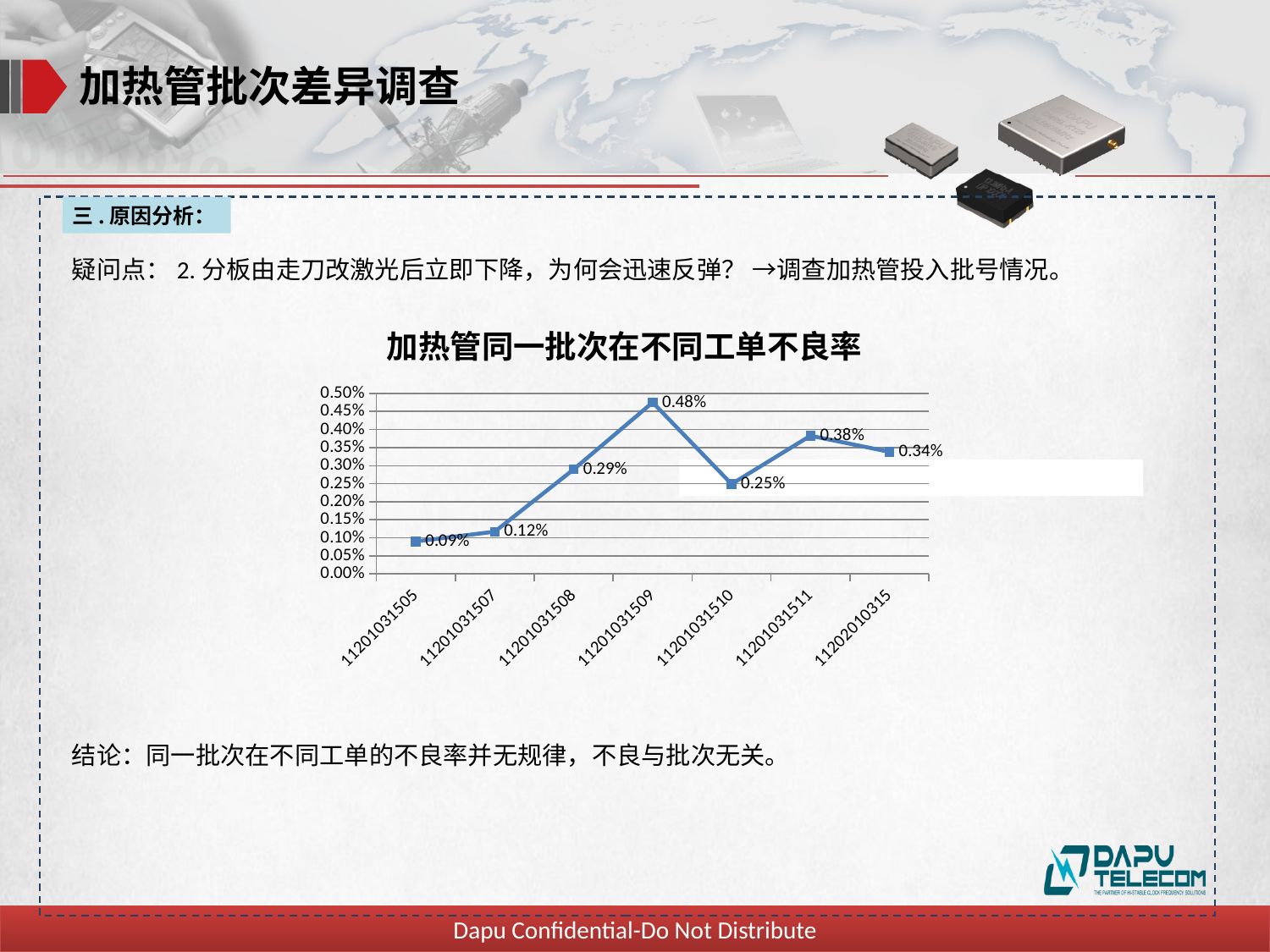
Does the defect rate rise or fall from work order 11201031505 to work order 11201031509? rise What is the defect rate for work order 11201031505? 0.09% What is the difference between the defect rates of work orders 11201031509 and 11201031510? 0.23% Which work order has the highest defect rate? 11201031509 How many work orders (data points) are plotted on the chart? 7 What is the defect rate for work order 11201031509? 0.48% What type of chart is shown on the slide? line chart Which work order has the lowest defect rate? 11201031505 Which has a higher defect rate, work order 11201031511 or work order 11201031508? 11201031511 What is the title of the chart? 加热管同一批次在不同工单不良率 What is the defect rate for work order 11202010315? 0.34% Is the defect rate for work order 11201031507 greater or less than 0.20%? less